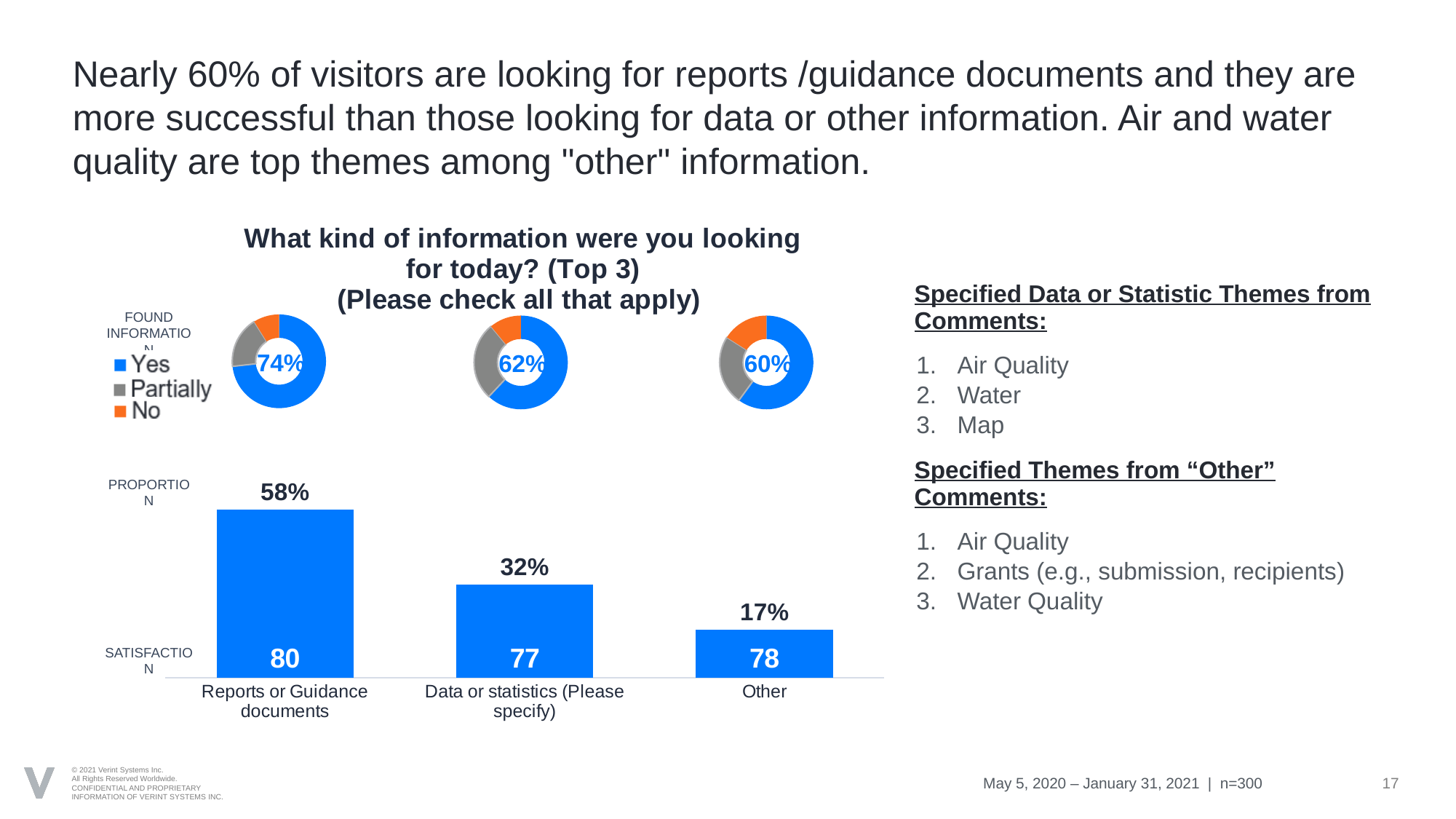
In the bar chart 'What kind of information were you looking for today? (Top 3)', how many categories are shown? 3 In the bar chart 'What kind of information were you looking for today? (Top 3)', what is the satisfaction score shown for Reports or Guidance documents? 80 What kind of chart is used to show the proportion of visitors looking for each kind of information? Bar chart In the bar chart 'What kind of information were you looking for today? (Top 3)', which category has the lowest proportion? Other In the 'Found Information' donut charts, what percentage of visitors looking for Other information answered Yes? 60% In the bar chart 'What kind of information were you looking for today? (Top 3)', what proportion of visitors were looking for Reports or Guidance documents? 58% In the bar chart 'What kind of information were you looking for today? (Top 3)', what proportion of visitors were looking for Data or statistics? 32% In the bar chart 'What kind of information were you looking for today? (Top 3)', what proportion of visitors were looking for Other information? 17% In the bar chart 'What kind of information were you looking for today? (Top 3)', what is the difference in proportion between Reports or Guidance documents and Data or statistics? 26% In the bar chart 'What kind of information were you looking for today? (Top 3)', which category has the highest proportion? Reports or Guidance documents In the bar chart 'What kind of information were you looking for today? (Top 3)', what is the satisfaction score shown for Data or statistics? 77 In the 'Found Information' donut charts, what percentage of visitors looking for Reports or Guidance documents answered Yes? 74%